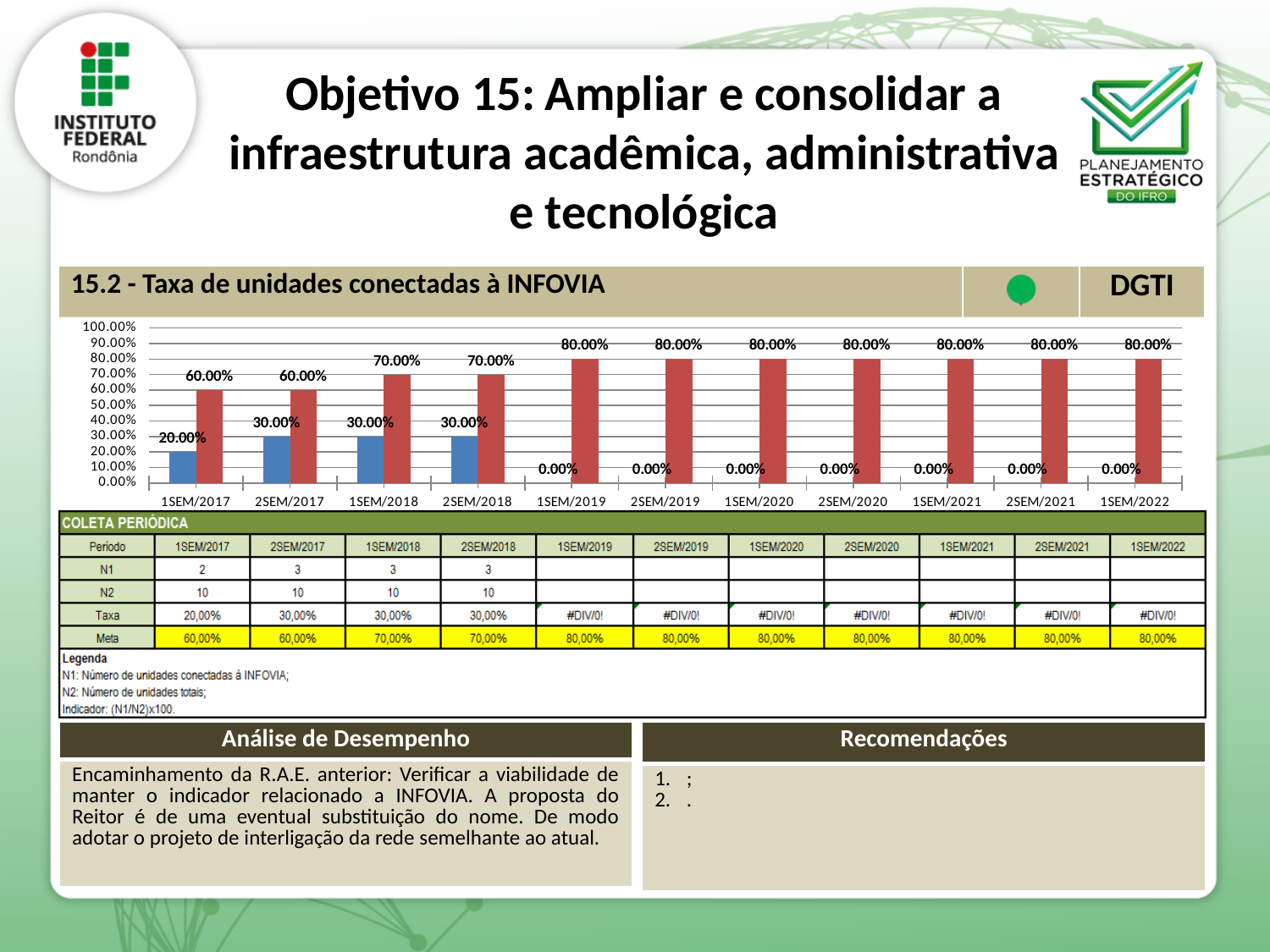
What value is labelled on the blue bar for 1SEM/2017? 20.00% What value is labelled on the red bar for 1SEM/2022? 80.00% What is the difference between the red bar and the blue bar for 1SEM/2017? 40.00% For 2SEM/2018, which bar is taller, the blue one or the red one? The red one What value is labelled on the red bar for 1SEM/2018? 70.00% Is the value of the blue bar for 2SEM/2017 greater or less than 50.00%? less What is the lowest value labelled on any blue bar in the chart? 0.00% Do the red bars rise or fall from 1SEM/2017 to 1SEM/2019? Rise What value is labelled on the blue bar for 2SEM/2019? 0.00% How many periods are shown along the x axis of the chart? 11 What is the highest value labelled on any red bar in the chart? 80.00% What kind of chart is shown on the slide? Bar chart